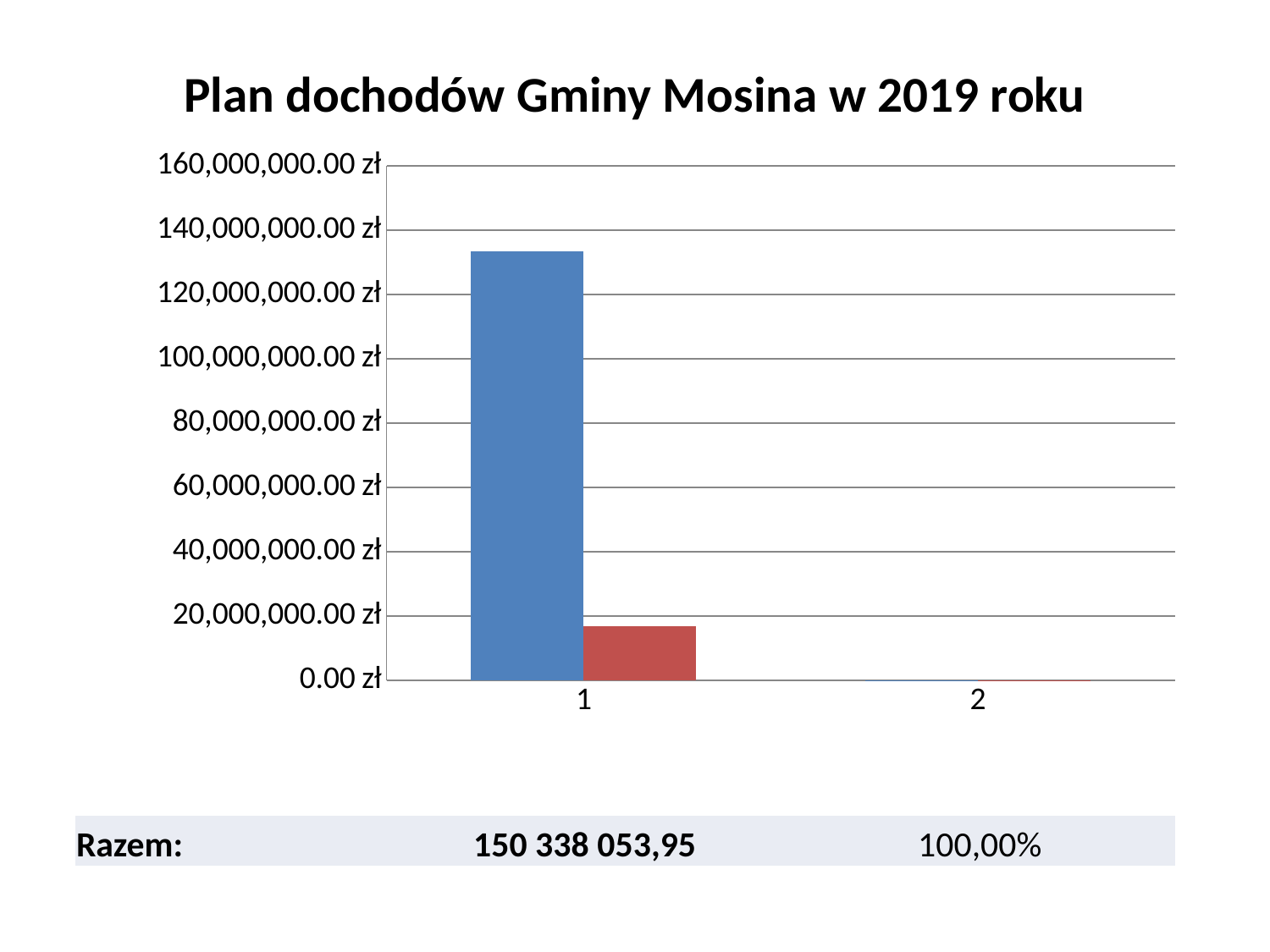
Is the value of the blue bar for category 2 greater or less than 20,000,000.00 zł? less Do the values rise or fall from category 1 to category 2? fall Is the value of the blue bar for category 1 greater or less than 140,000,000.00 zł? less For category 1, which bar is larger, the blue one or the red one? the blue one How many categories are shown on the x axis of the chart? 2 What is the title of the chart? Plan dochodów Gminy Mosina w 2019 roku Is the value of the red bar for category 1 greater or less than 20,000,000.00 zł? less Which category has the tallest bar in the chart? 1 What kind of chart is shown on the slide? bar chart How many bars are plotted for category 1? 2 Which category has the lowest values in the chart? 2